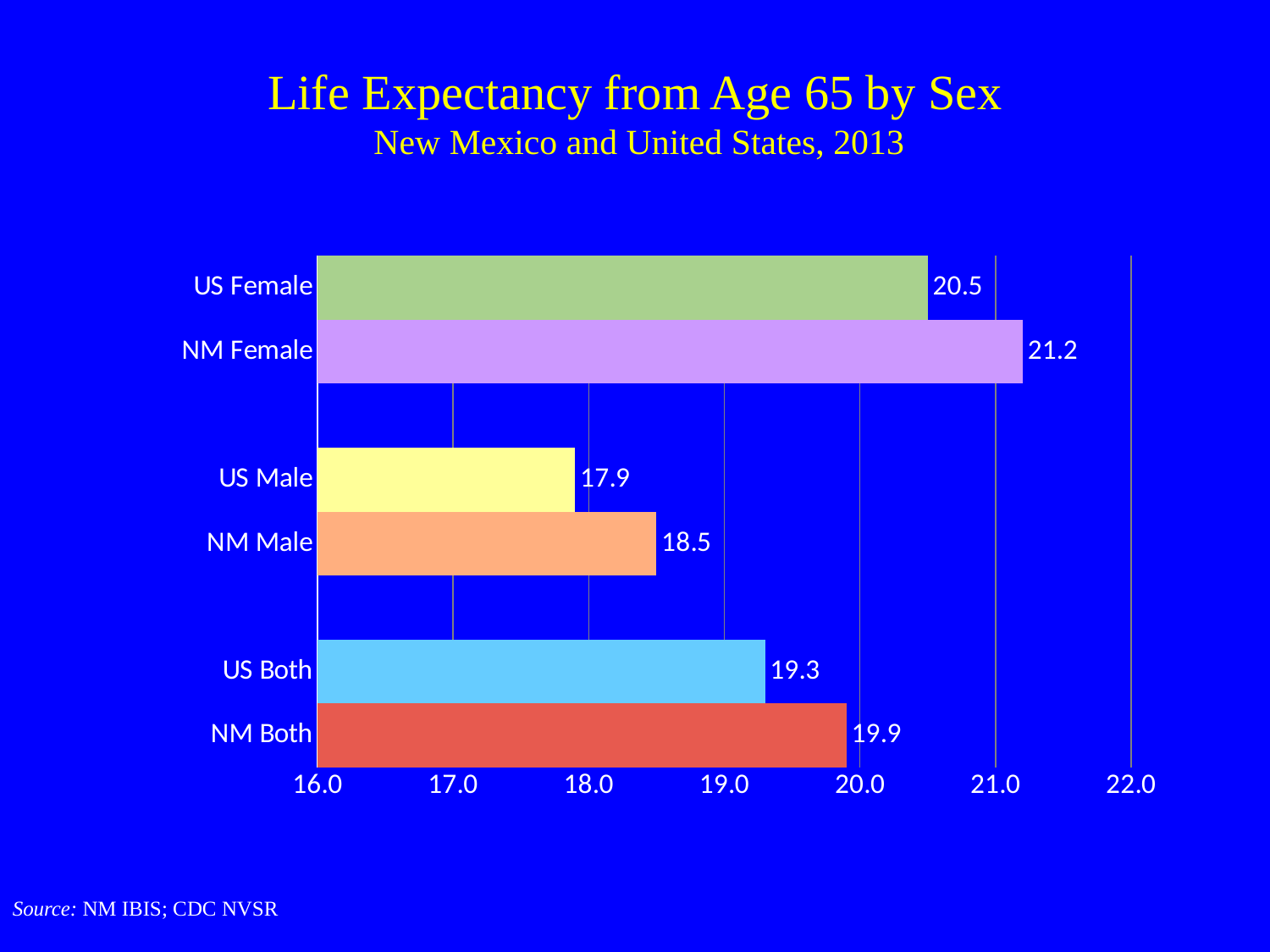
What is the life expectancy from age 65 for US Male? 17.9 What is the difference between NM Female and US Female life expectancy from age 65? 0.7 What is the title of the chart? Life Expectancy from Age 65 by Sex, New Mexico and United States, 2013 Is the value for US Female greater or less than 20.0? greater How many bars are shown in the chart? 6 What is the value shown for NM Both? 19.9 Which is larger, the value for NM Both or US Both? NM Both Which category has the lowest life expectancy from age 65? US Male What kind of chart is shown on the slide? bar chart What is the life expectancy from age 65 for NM Female? 21.2 Which category has the highest life expectancy from age 65? NM Female What is the difference between NM Male and US Male life expectancy from age 65? 0.6